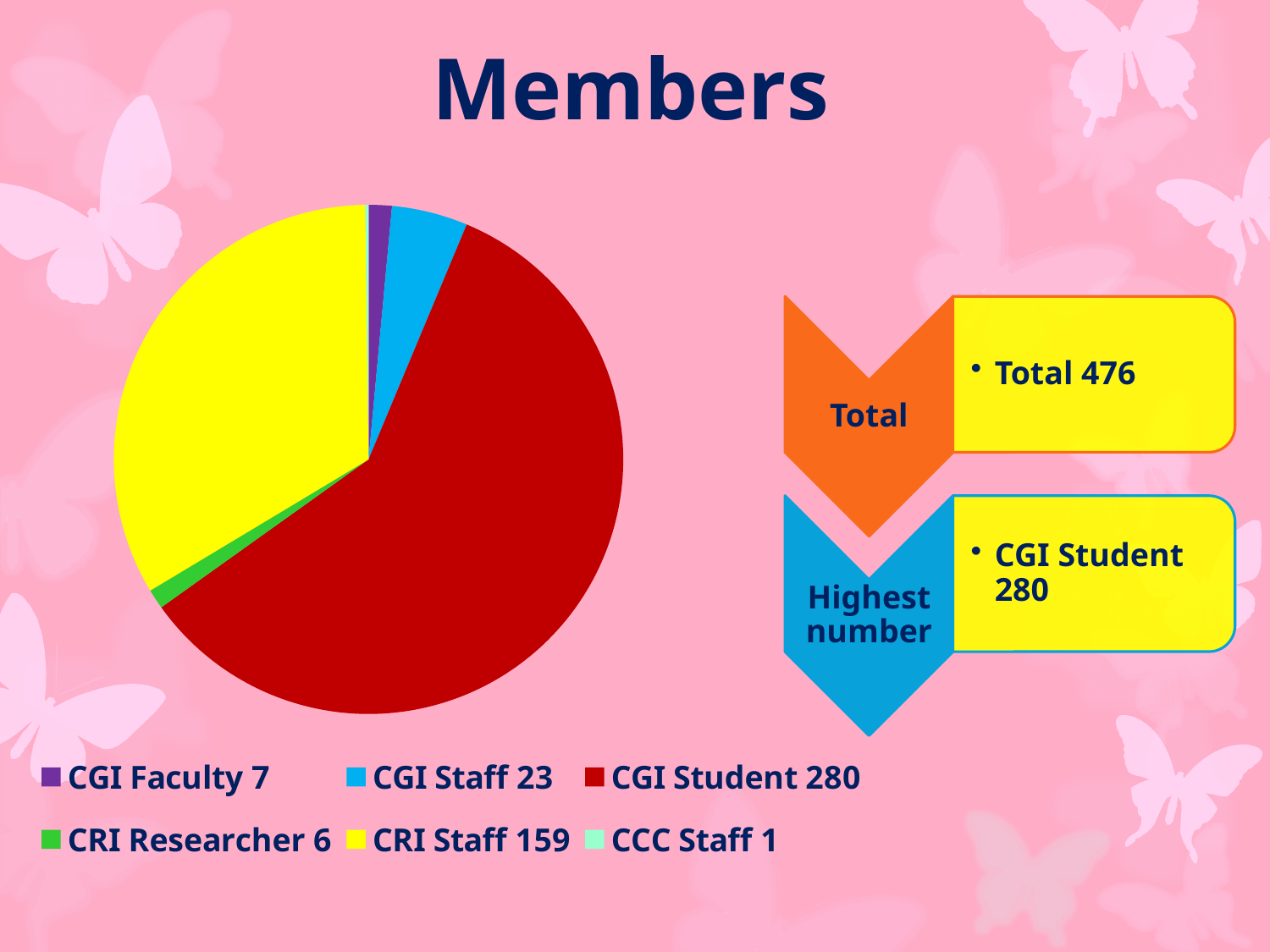
What kind of chart is shown on the slide? Pie chart What is the total number of members shown on the slide? 476 What is the value for CGI Staff in the pie chart? 23 Which category has the largest slice of the pie chart? CGI Student How many categories does the pie chart's legend list? 6 What is the value for CRI Researcher in the pie chart? 6 What is the title of the chart slide? Members Which category has the smallest slice of the pie chart? CCC Staff What is the difference between the CGI Student value and the CRI Staff value? 121 Which is larger, the value for CGI Faculty or the value for CGI Staff? CGI Staff What is the value for CRI Staff in the pie chart? 159 What is the value for CGI Student in the pie chart? 280